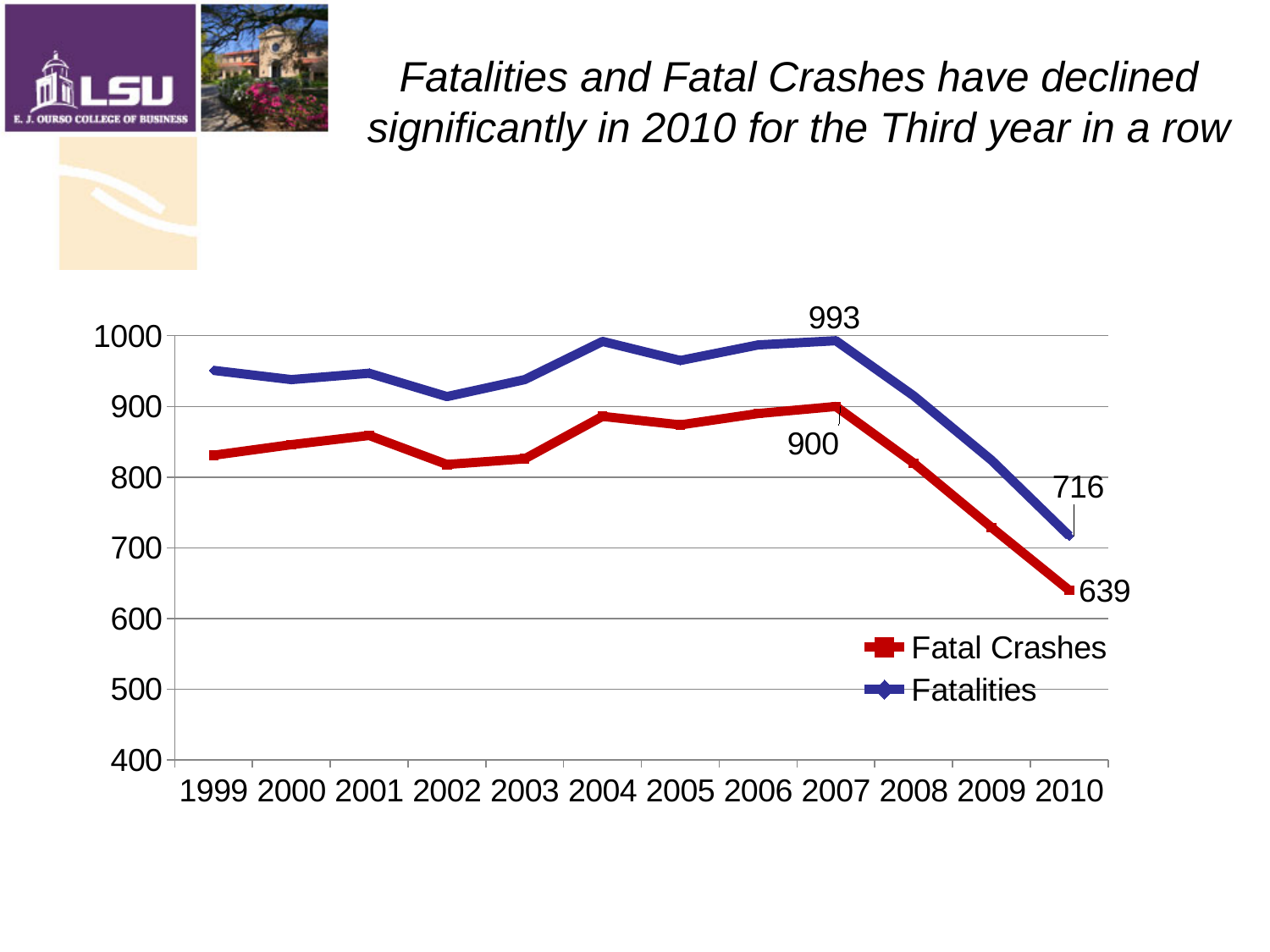
Do the Fatalities values rise or fall from 2007 to 2010? fall What is the difference between Fatalities in 2007 and Fatalities in 2010? 277 What is the value for Fatalities in 2010? 716 What is the value for Fatal Crashes in 2010? 639 What kind of chart is shown on the slide? line chart What is the value for Fatalities in 2007? 993 Which is larger in 2010, Fatalities or Fatal Crashes? Fatalities How many series does the legend list? 2 Is the value for Fatal Crashes in 1999 greater or less than 900? less Is the value for Fatalities in 2004 greater or less than 900? greater What is the value for Fatal Crashes in 2007? 900 What is the difference between Fatalities and Fatal Crashes in 2007? 93